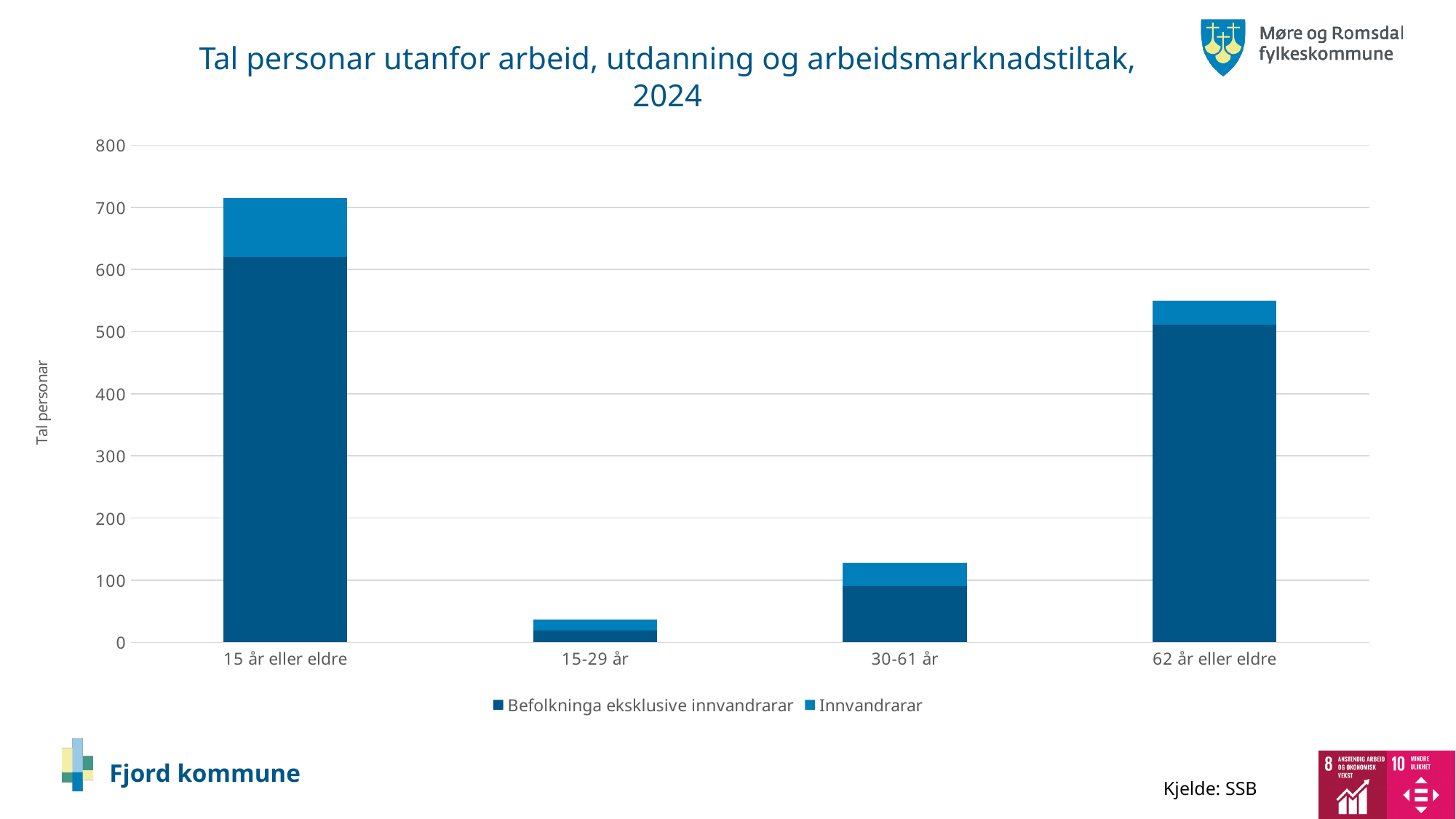
Which age category has the shortest stacked bar? 15-29 år What is the label on the y axis? Tal personar Which stacked bar is taller: 30-61 år or 62 år eller eldre? 62 år eller eldre Is the total value for 15-29 år greater or less than 100? less What is the title of the chart? Tal personar utanfor arbeid, utdanning og arbeidsmarknadstiltak, 2024 Is the total value for 15 år eller eldre greater or less than 700? greater How many series does the legend list? 2 What kind of chart is shown on the slide? Stacked bar chart Is the total value for 62 år eller eldre greater or less than 600? less Which age category has the tallest stacked bar? 15 år eller eldre How many age categories are shown on the x axis? 4